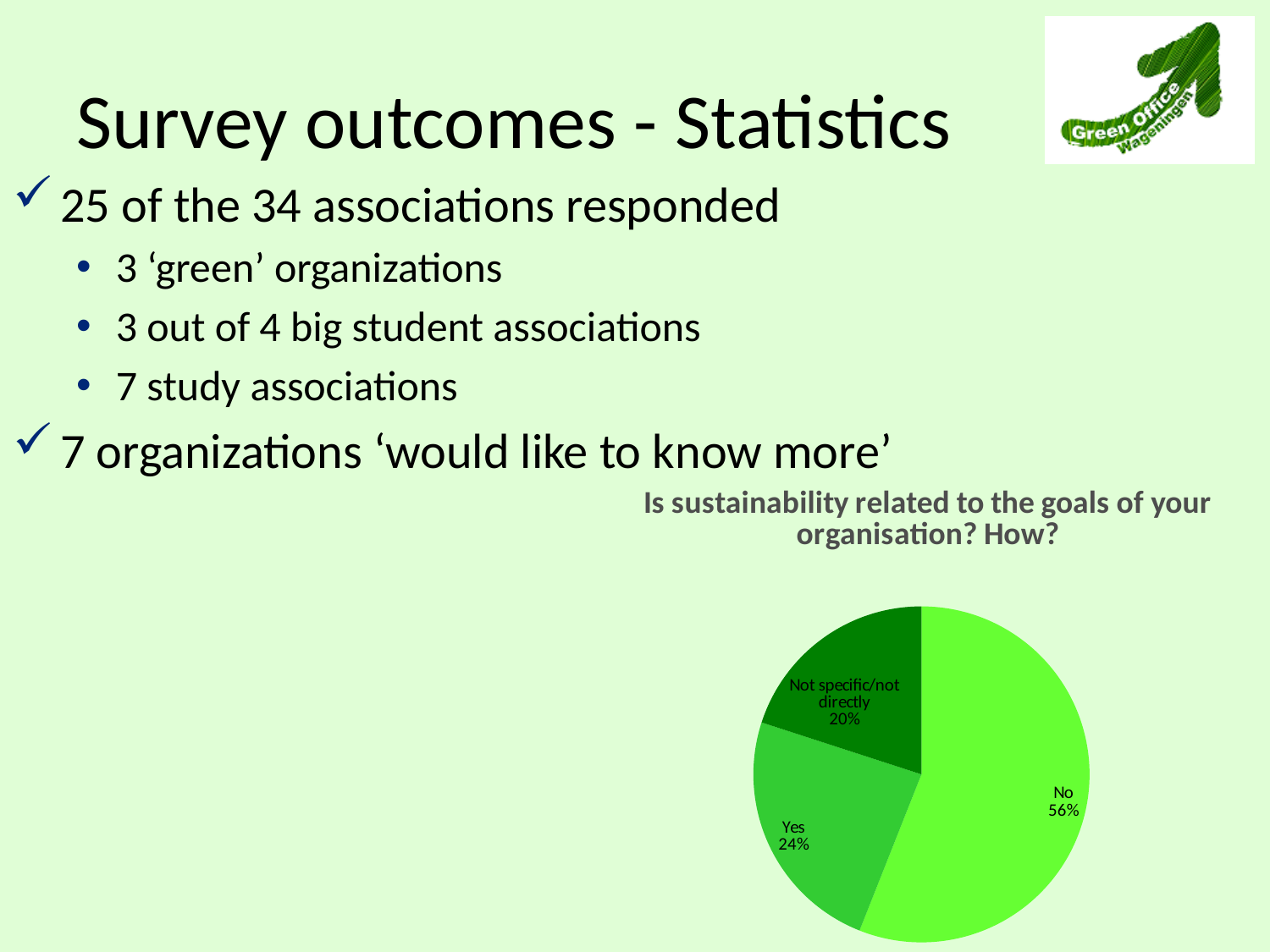
Which slice of the pie chart is the smallest? Not specific/not directly Is the 'No' slice greater or less than 50% of the pie? greater What kind of chart is shown on the slide? pie chart What percentage of the pie is the 'Yes' slice? 24% What is the difference in percentage points between the 'No' slice and the 'Yes' slice? 32 Which is larger, the 'Yes' slice or the 'Not specific/not directly' slice? Yes What is the title of the pie chart? Is sustainability related to the goals of your organisation? How? What is the combined share of the 'Yes' and 'Not specific/not directly' slices? 44% What percentage of the pie is the 'Not specific/not directly' slice? 20% Which slice of the pie chart is the largest? No How many slices does the pie chart have? 3 What percentage of the pie is the 'No' slice? 56%